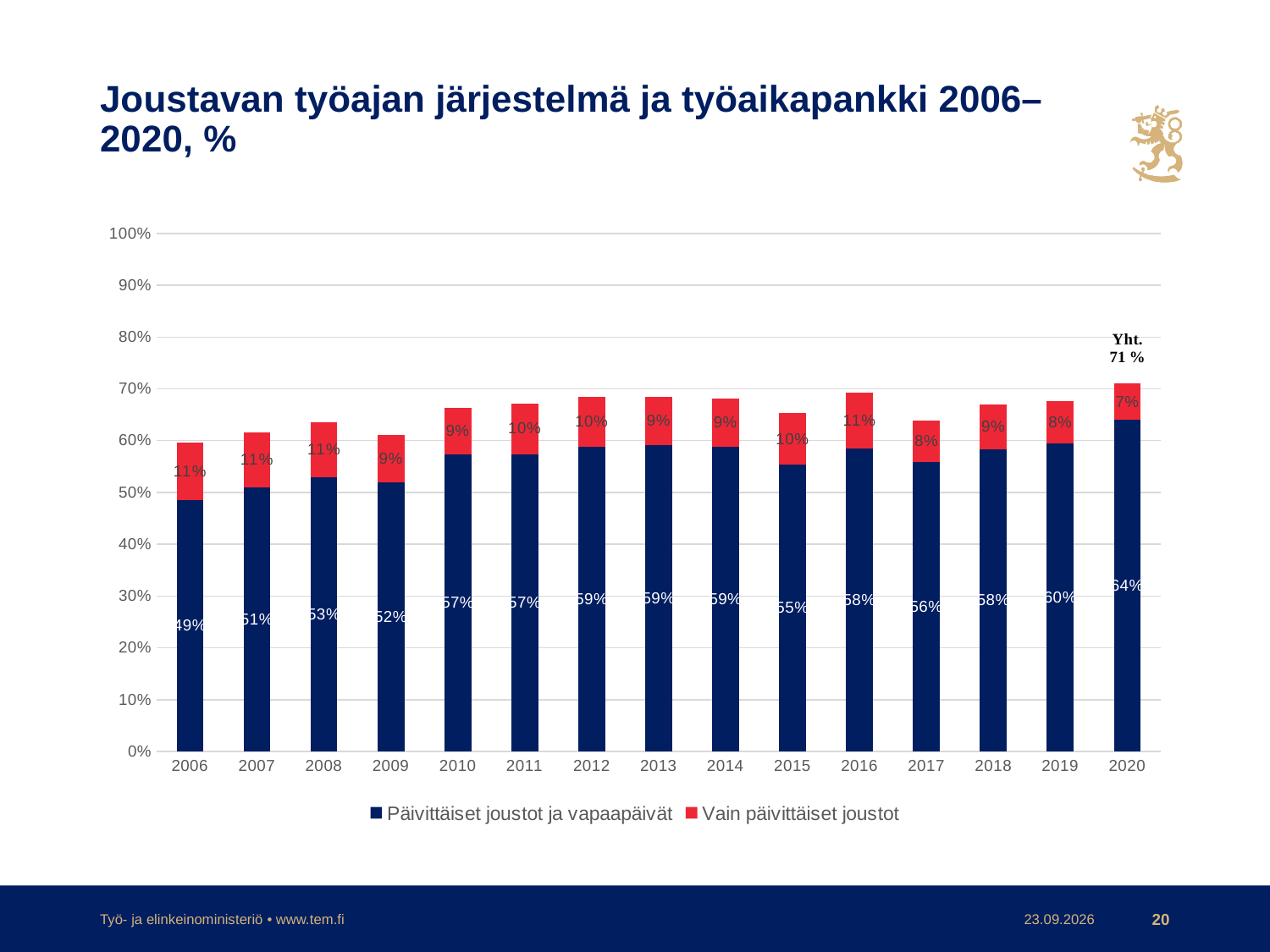
What is the value for Päivittäiset joustot ja vapaapäivät in 2020? 64% Which year has the lowest value for Vain päivittäiset joustot? 2020 Which is larger, the Päivittäiset joustot ja vapaapäivät value for 2019 or for 2017? 2019 What is the value for Päivittäiset joustot ja vapaapäivät in 2015? 55% Which year has the highest value for Päivittäiset joustot ja vapaapäivät? 2020 Which year has the lowest value for Päivittäiset joustot ja vapaapäivät? 2006 What is the difference between the Päivittäiset joustot ja vapaapäivät values for 2020 and 2006? 15 percentage points What kind of chart is shown on the slide? Stacked bar chart What is the value for Vain päivittäiset joustot in 2006? 11% What is the total of the stacked bar for 2020? 71 % How many series does the legend list? 2 How many years are shown on the x axis? 15